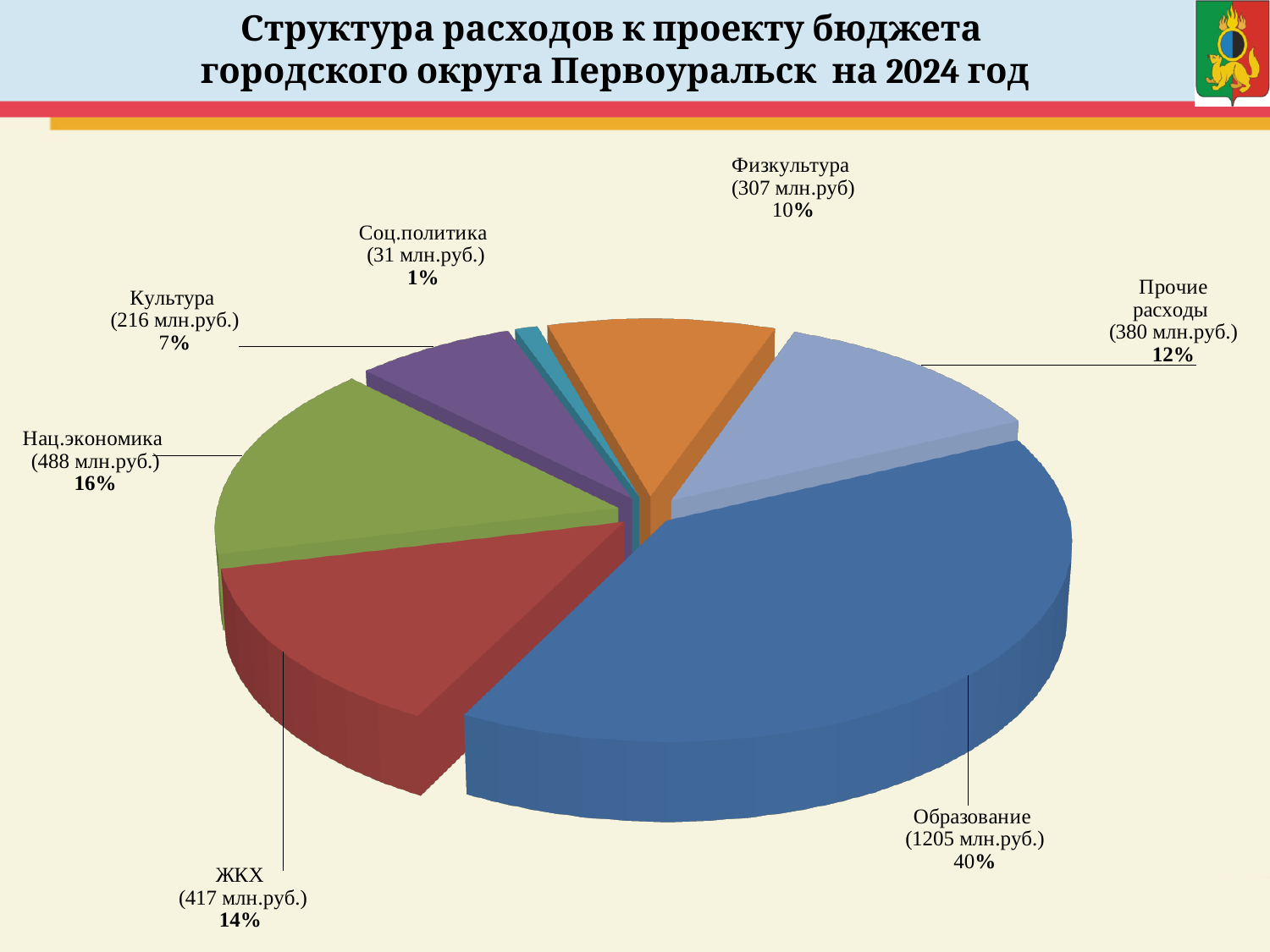
Which category has the smallest share of the pie? Соц.политика Which category has the largest share of the pie? Образование What is the value for Нац.экономика? 488 млн.руб. What percentage is shown for ЖКХ? 14% How many slices does the pie chart have? 7 What kind of chart is shown on the slide? pie chart What is the difference in млн.руб. between Нац.экономика and ЖКХ? 71 млн.руб. What is the value for Образование in the pie chart? 1205 млн.руб. What is the title of the slide containing the chart? Структура расходов к проекту бюджета городского округа Первоуральск на 2024 год Which is larger, Прочие расходы or Физкультура? Прочие расходы What share of the pie does Образование take? 40% What is the value for Культура? 216 млн.руб.